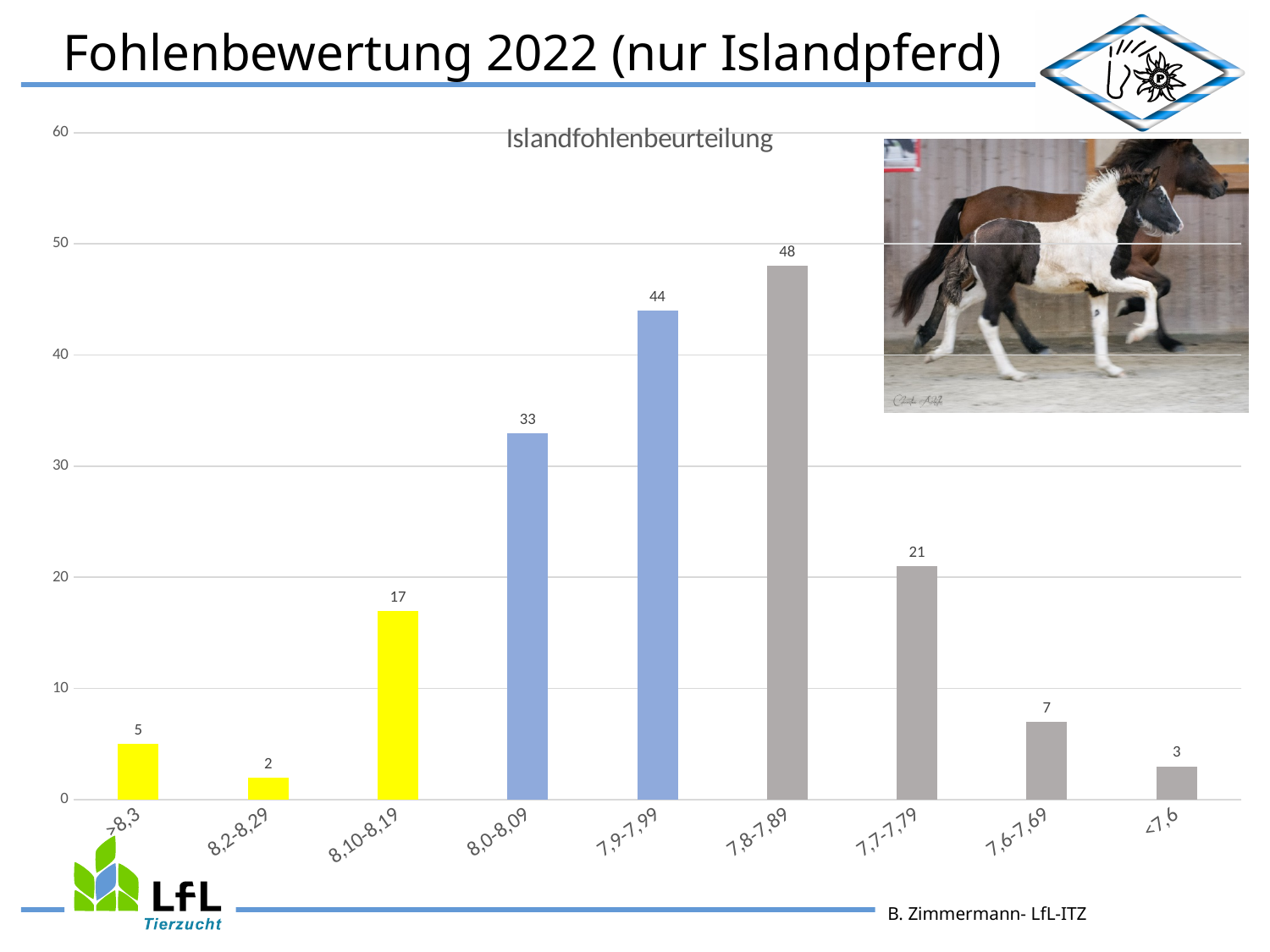
What is the value for the category 7,8-7,89? 48 Which category has the lowest value? 8,2-8,29 Is the value for 8,0-8,09 greater or less than 30? greater Which is larger, the value for 7,7-7,79 or the value for 8,10-8,19? 7,7-7,79 What is the title of the chart? Islandfohlenbeurteilung What is the value for the category <7,6? 3 How many categories are shown on the x axis? 9 What colour are the bars for the categories >8,3, 8,2-8,29 and 8,10-8,19? yellow What kind of chart is shown on the slide? bar chart Which category has the highest value? 7,8-7,89 What is the difference between the values for 7,9-7,99 and 8,0-8,09? 11 What is the value for the category 8,10-8,19? 17